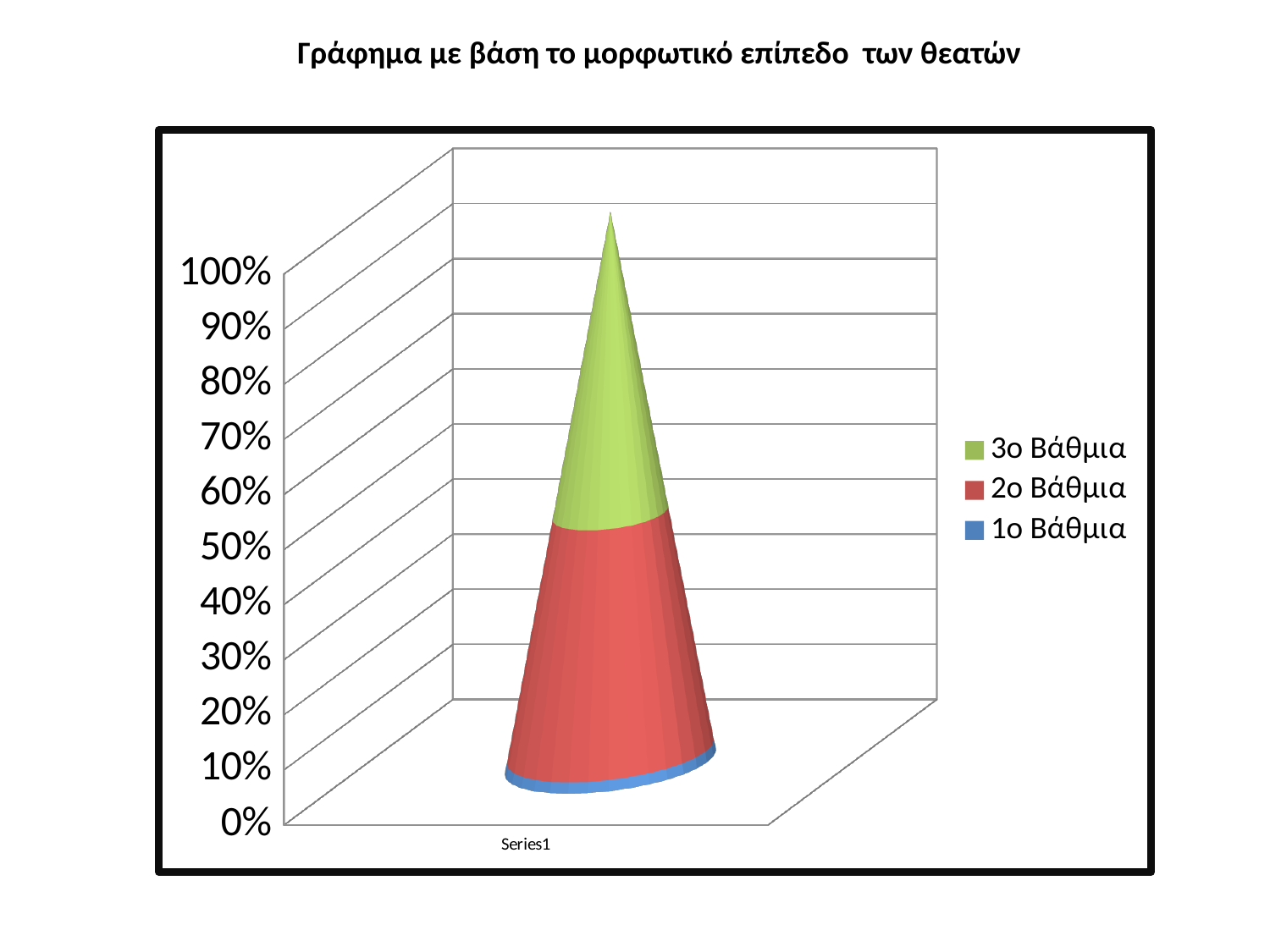
Which is larger, the segment for 1ο Βάθμια or the segment for 2ο Βάθμια? 2ο Βάθμια What kind of chart is shown on the slide? Stacked bar chart Which series has the smallest segment in the stacked bar? 1ο Βάθμια Is the value for 2ο Βάθμια greater or less than 20%? greater What is the label of the category on the x axis? Series1 Is the value for 1ο Βάθμια greater or less than 10%? less How many categories are plotted on the x axis? 1 Is the value for 3ο Βάθμια greater or less than 20%? greater How many series does the legend list? 3 Which is larger, the segment for 1ο Βάθμια or the segment for 3ο Βάθμια? 3ο Βάθμια What is the title of the chart? Γράφημα με βάση το μορφωτικό επίπεδο των θεατών